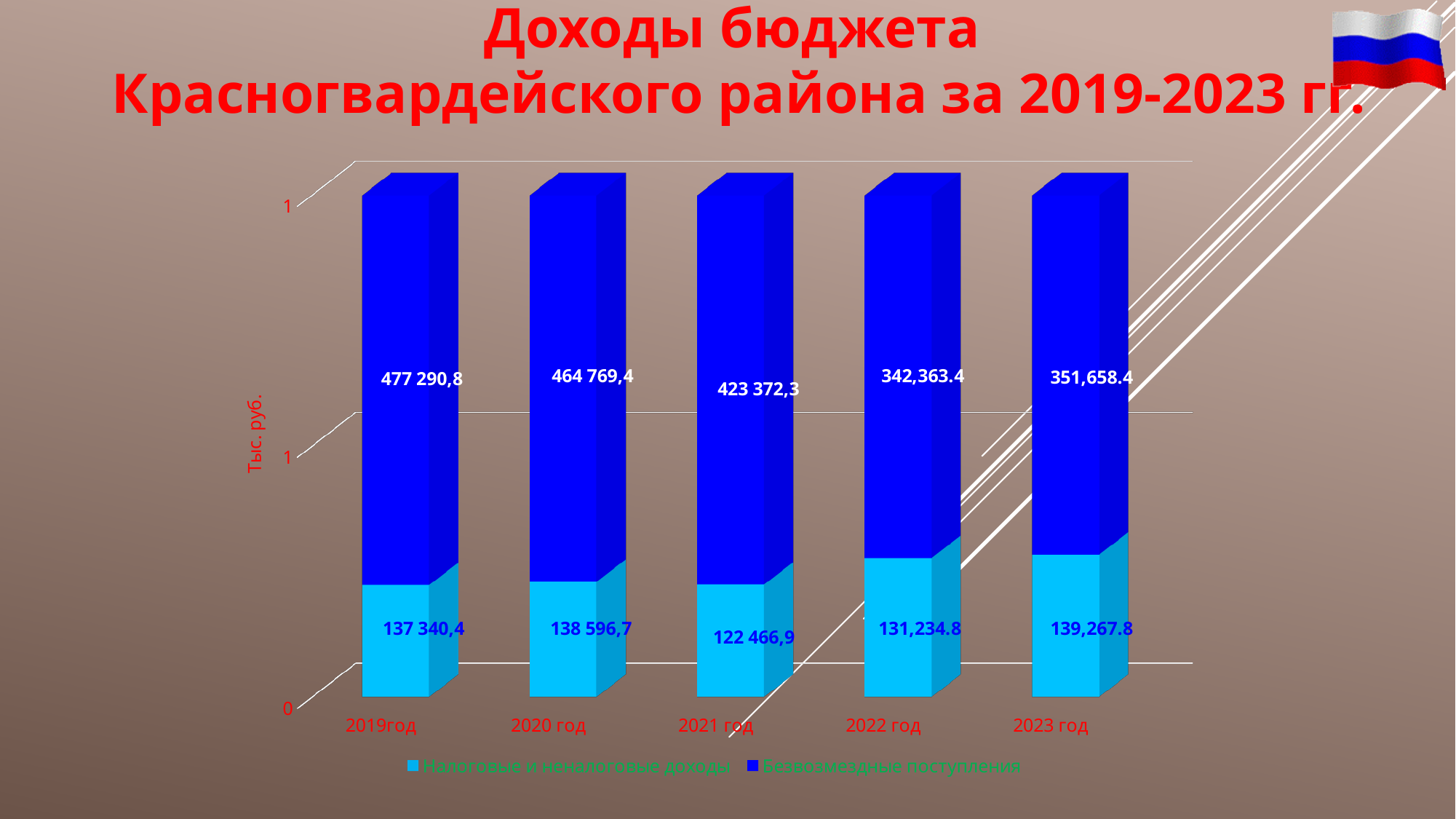
What is the value of Безвозмездные поступления for 2019 год? 477 290,8 How many years are shown on the x axis? 5 What is the value of Налоговые и неналоговые доходы for 2021 год? 122 466,9 What is the value of Налоговые и неналоговые доходы for 2023 год? 139,267.8 What is the value of Безвозмездные поступления for 2022 год? 342,363.4 Which is larger in 2020 год: Налоговые и неналоговые доходы or Безвозмездные поступления? Безвозмездные поступления Does Безвозмездные поступления rise or fall from 2019 год to 2022 год? Fall What is the difference between Безвозмездные поступления and Налоговые и неналоговые доходы in 2022 год? 211,128.6 In which year is Налоговые и неналоговые доходы the lowest? 2021 год What kind of chart is shown on the slide? Stacked bar chart In which year is Безвозмездные поступления the highest? 2019год How many series does the legend list? 2